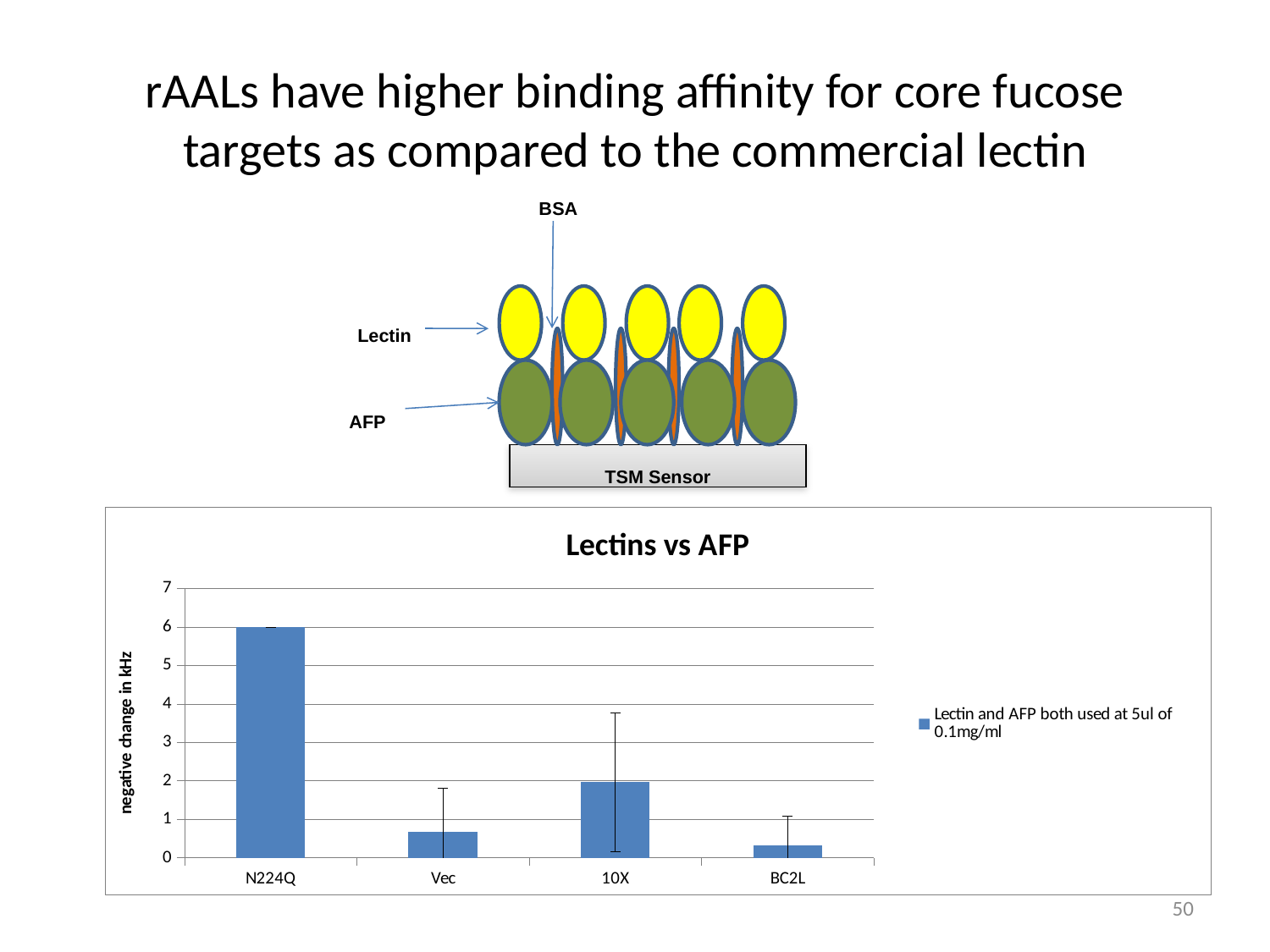
What is the y-axis label of the "Lectins vs AFP" chart? negative change in kHz In the "Lectins vs AFP" chart, which is larger, the value for N224Q or the value for 10X? N224Q Which category has the lowest value in the "Lectins vs AFP" chart? BC2L How many series does the legend of the "Lectins vs AFP" chart list? 1 In the "Lectins vs AFP" chart, is the value for 10X greater or less than 1? greater In the "Lectins vs AFP" chart, is the value for N224Q greater or less than 5? greater In the "Lectins vs AFP" chart, is the value for Vec greater or less than 1? less In the "Lectins vs AFP" chart, which is larger, the value for 10X or the value for Vec? 10X What type of chart is shown under the title "Lectins vs AFP"? bar chart How many categories are shown on the x axis of the "Lectins vs AFP" chart? 4 Which category has the highest value in the "Lectins vs AFP" chart? N224Q